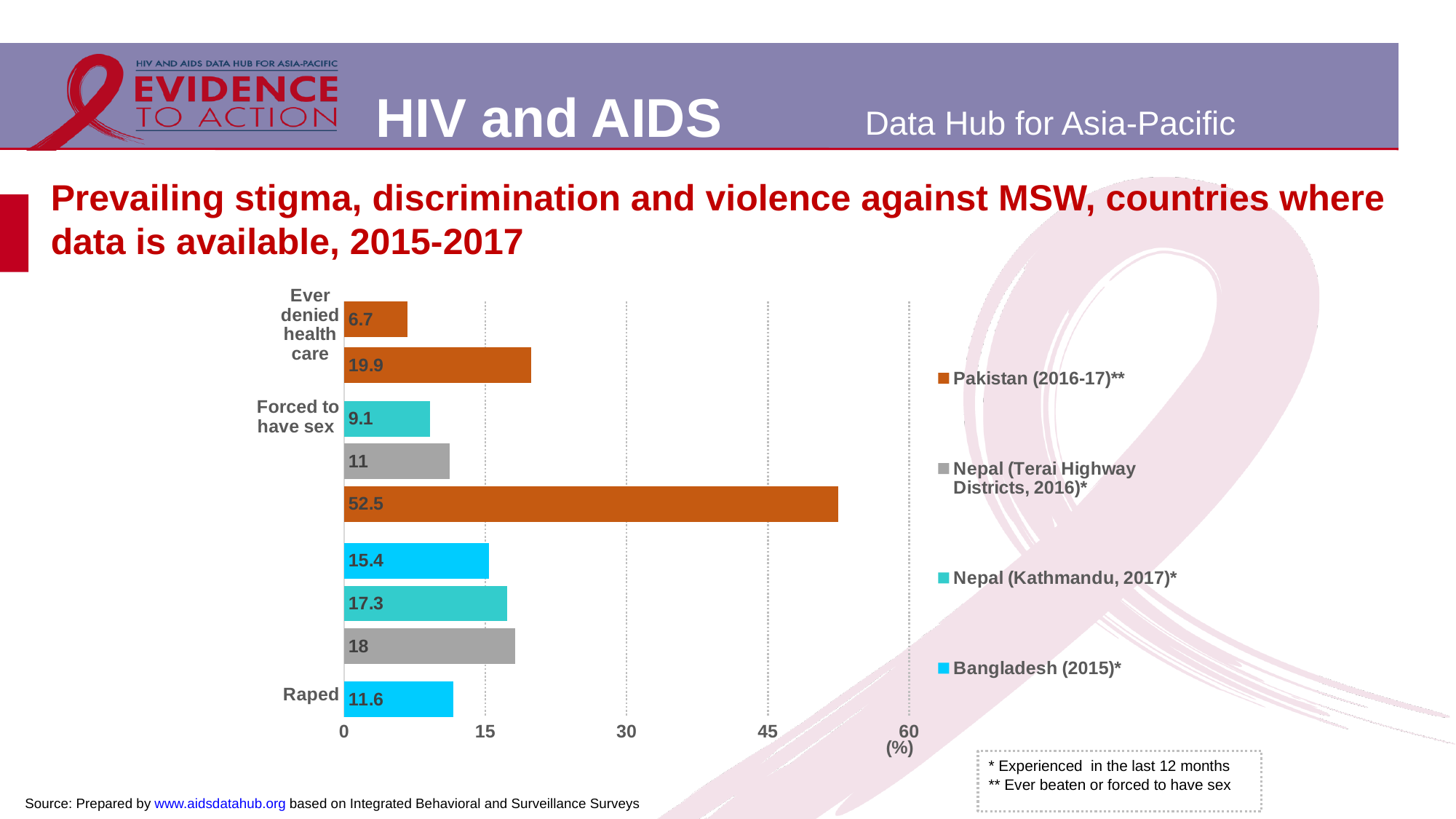
What unit is shown at the end of the x axis? (%) What kind of chart is shown on the slide? bar chart How many series does the legend list? 4 Is the longest bar on the chart greater or less than 45? greater Which legend entry is shown in light blue? Bangladesh (2015)* What is the highest value shown on the chart? 52.5 What is the value of the Bangladesh (2015) bar for 'Raped'? 11.6 What is the lowest value shown on the chart? 6.7 What is the value for Nepal (Kathmandu, 2017) for 'Forced to have sex'? 9.1